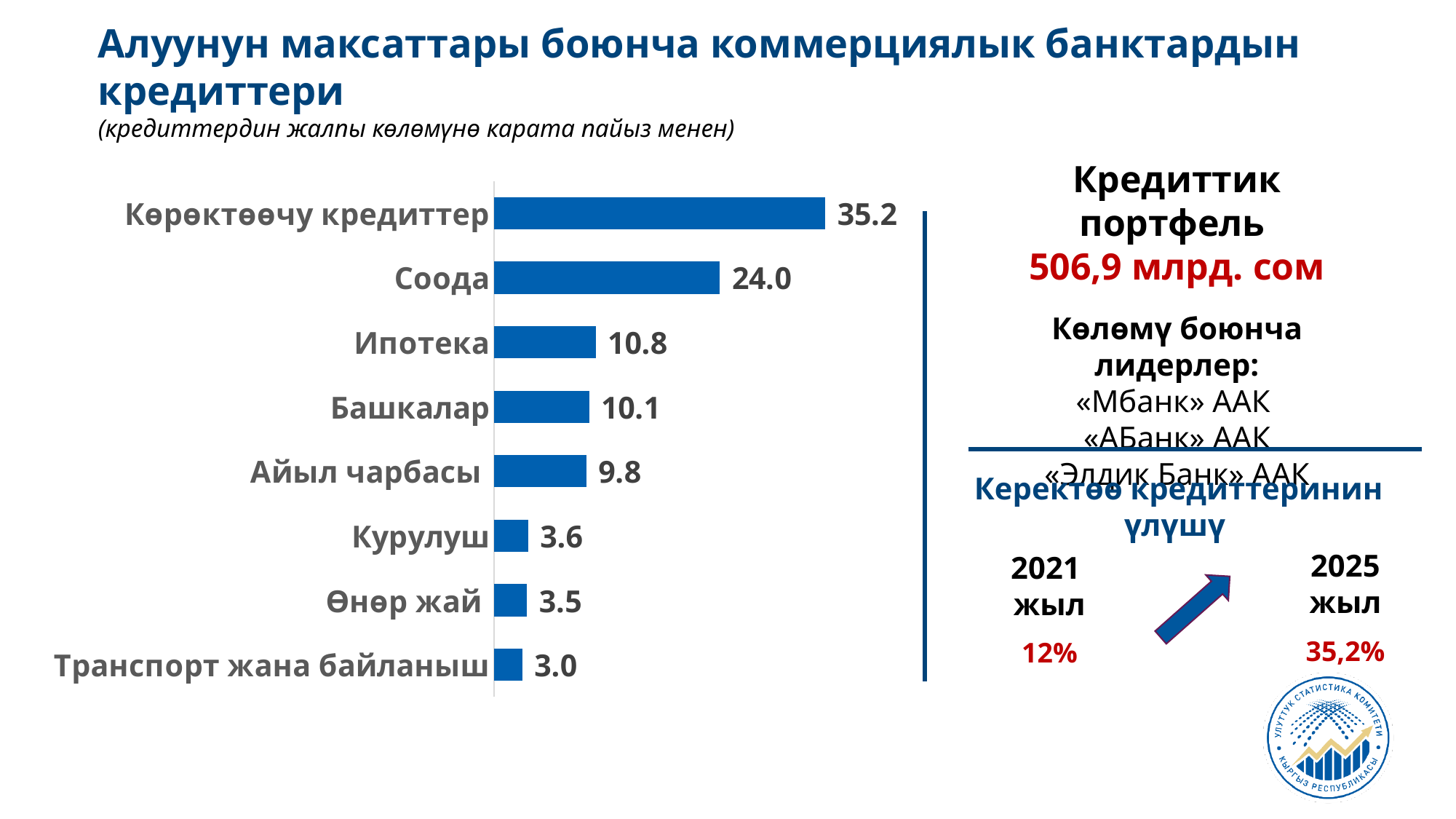
What is the difference between the values for Көрөктөөчу кредиттер and Соода? 11.2 Which is larger, the value for Курулуш or the value for Айыл чарбасы? Айыл чарбасы What is the value for Соода? 24.0 What is the value for Көрөктөөчу кредиттер? 35.2 How many categories are shown in the chart? 8 Which category has the highest value? Көрөктөөчу кредиттер Which category has the lowest value? Транспорт жана байланыш What is the value for Ипотека? 10.8 What is the value for Айыл чарбасы? 9.8 What is the difference between the values for Ипотека and Башкалар? 0.7 What is the value for Транспорт жана байланыш? 3.0 What kind of chart is shown on the slide? Bar chart